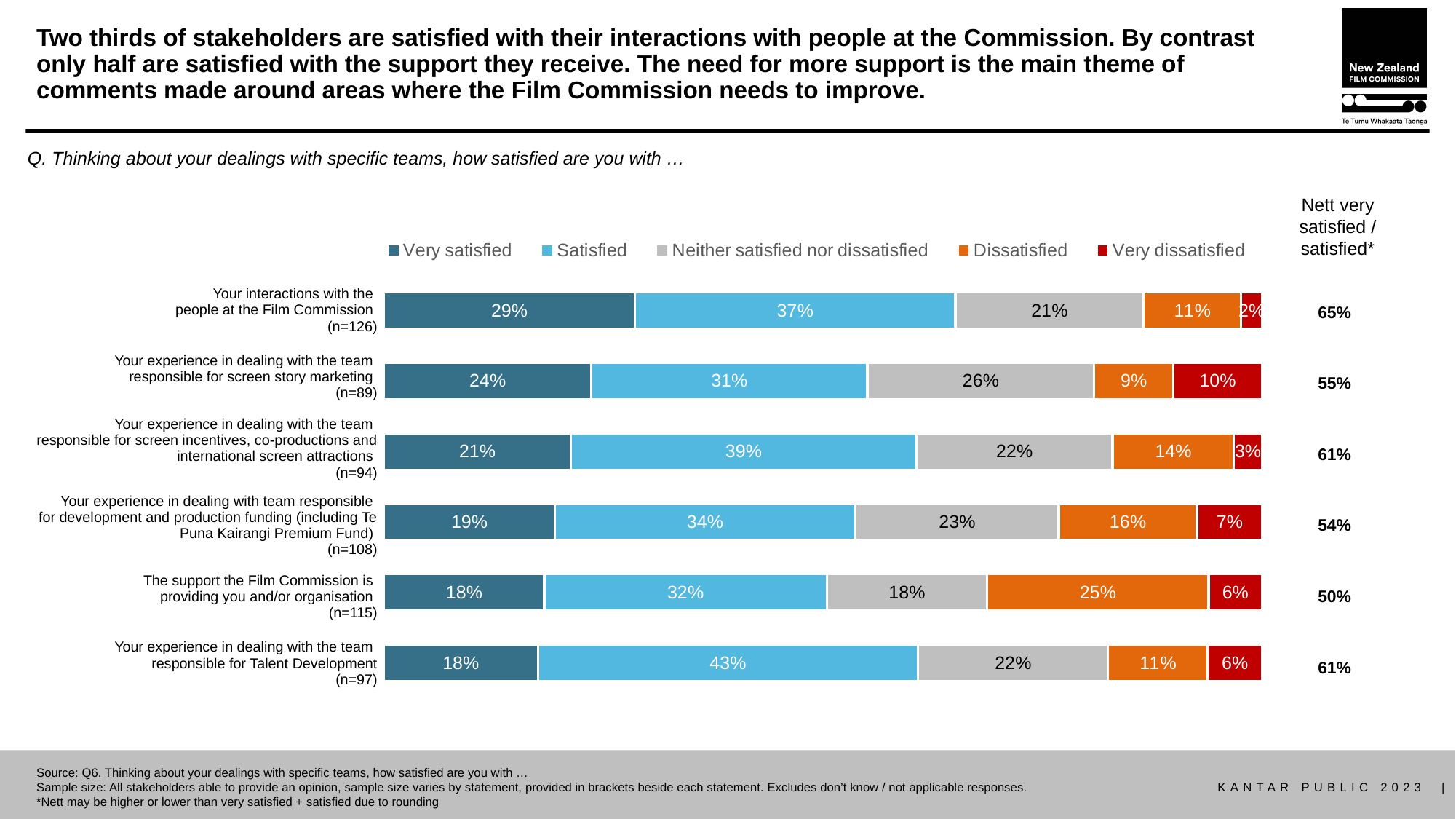
What percentage of stakeholders are 'Very satisfied' with their interactions with the people at the Film Commission? 29% How many series does the legend list? 5 What is the difference between the nett satisfied percentage for interactions with people at the Film Commission and for the support the Film Commission is providing? 15 percentage points Which is larger: the 'Neither satisfied nor dissatisfied' share for screen story marketing or for development and production funding? Screen story marketing (26%) Which statement has the lowest nett very satisfied / satisfied percentage? The support the Film Commission is providing you and/or organisation Which statement has the highest 'Very dissatisfied' percentage? Your experience in dealing with the team responsible for screen story marketing What is the 'Satisfied' percentage for the team responsible for Talent Development? 43% What is the sample size (n) for the statement about the team responsible for screen incentives, co-productions and international screen attractions? n=94 What kind of chart is shown on the slide? Stacked bar chart Which statement has the highest 'Very satisfied' percentage? Your interactions with the people at the Film Commission How many statements (categories) are plotted in the chart? 6 What percentage are 'Dissatisfied' with the support the Film Commission is providing to them and/or their organisation? 25%